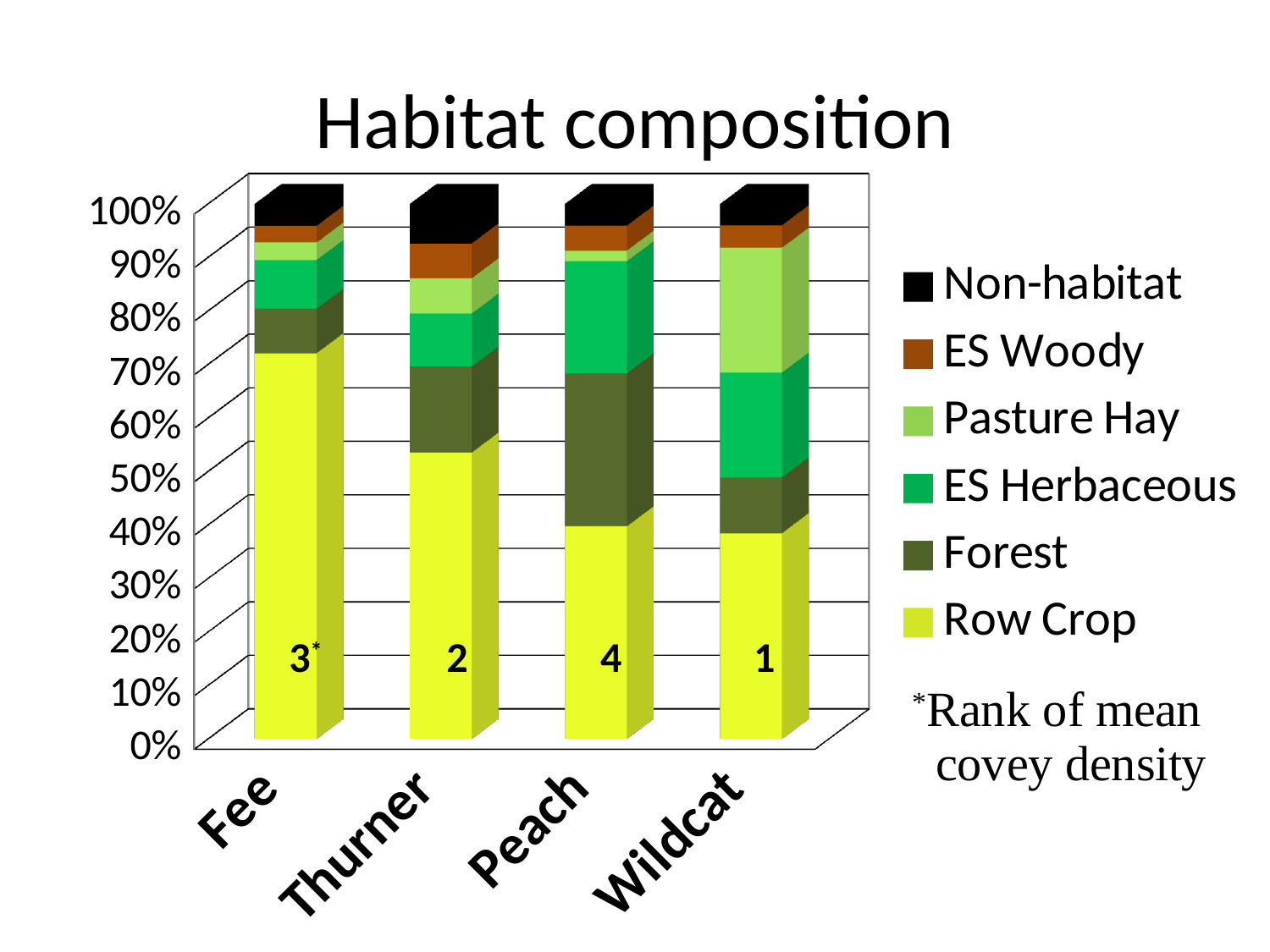
How many series does the legend list? 6 Which site has rank 1 of mean covey density printed on its bar? Wildcat Which series is shown in black in the legend? Non-habitat What kind of chart is shown on the slide? stacked bar chart Which site has the largest Non-habitat share? Thurner Is the Row Crop share for Thurner greater or less than 50%? greater Which site has the largest Row Crop share? Fee Which site has the largest Pasture Hay share? Wildcat How many sites (categories) are shown on the x axis? 4 What is the title of the chart? Habitat composition What rank of mean covey density is printed on the Peach bar? 4 Is the Row Crop share for Wildcat greater or less than 50%? less